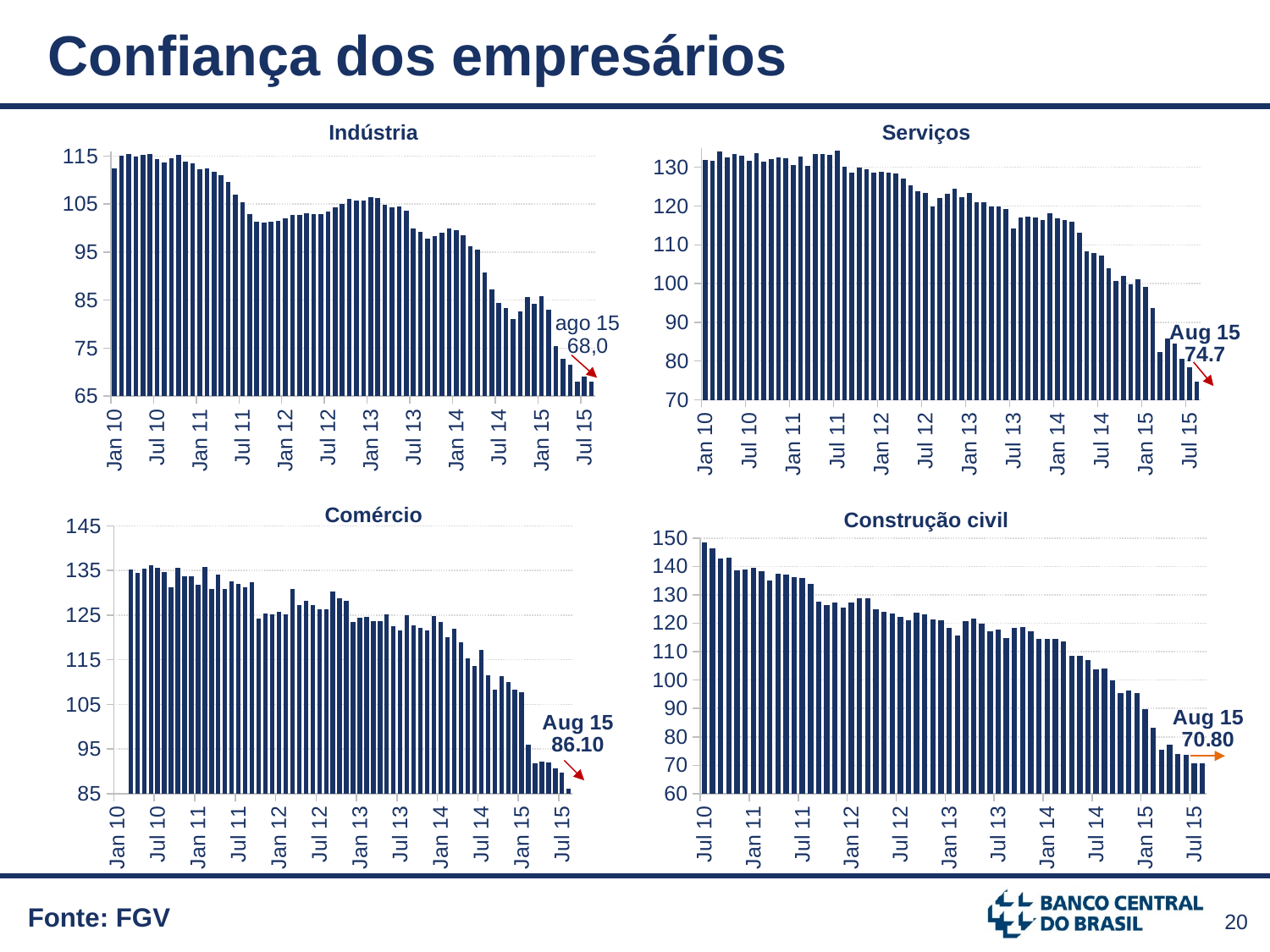
What kind of chart is the Indústria chart? bar chart In the Indústria chart, is the value for Jan 10 greater or less than 105? greater In the Comércio chart, what value is annotated for Aug 15? 86.10 In the Construção civil chart, do the values generally rise or fall from Jul 10 to Jul 15? fall In the Indústria chart, what value is annotated for ago 15? 68,0 In the Serviços chart, what value is annotated for Aug 15? 74.7 In the Construção civil chart, what value is annotated for Aug 15? 70.80 In the Serviços chart, is the value for Jan 11 greater or less than 120? greater What source is cited for the charts on the slide? FGV In the Serviços chart, do the values generally rise or fall from Jan 10 to Jul 15? fall In the Indústria chart, which is larger, the value for Jan 13 or the value for Jan 15? Jan 13 In the Comércio chart, is the value for Jan 15 greater or less than 105? greater